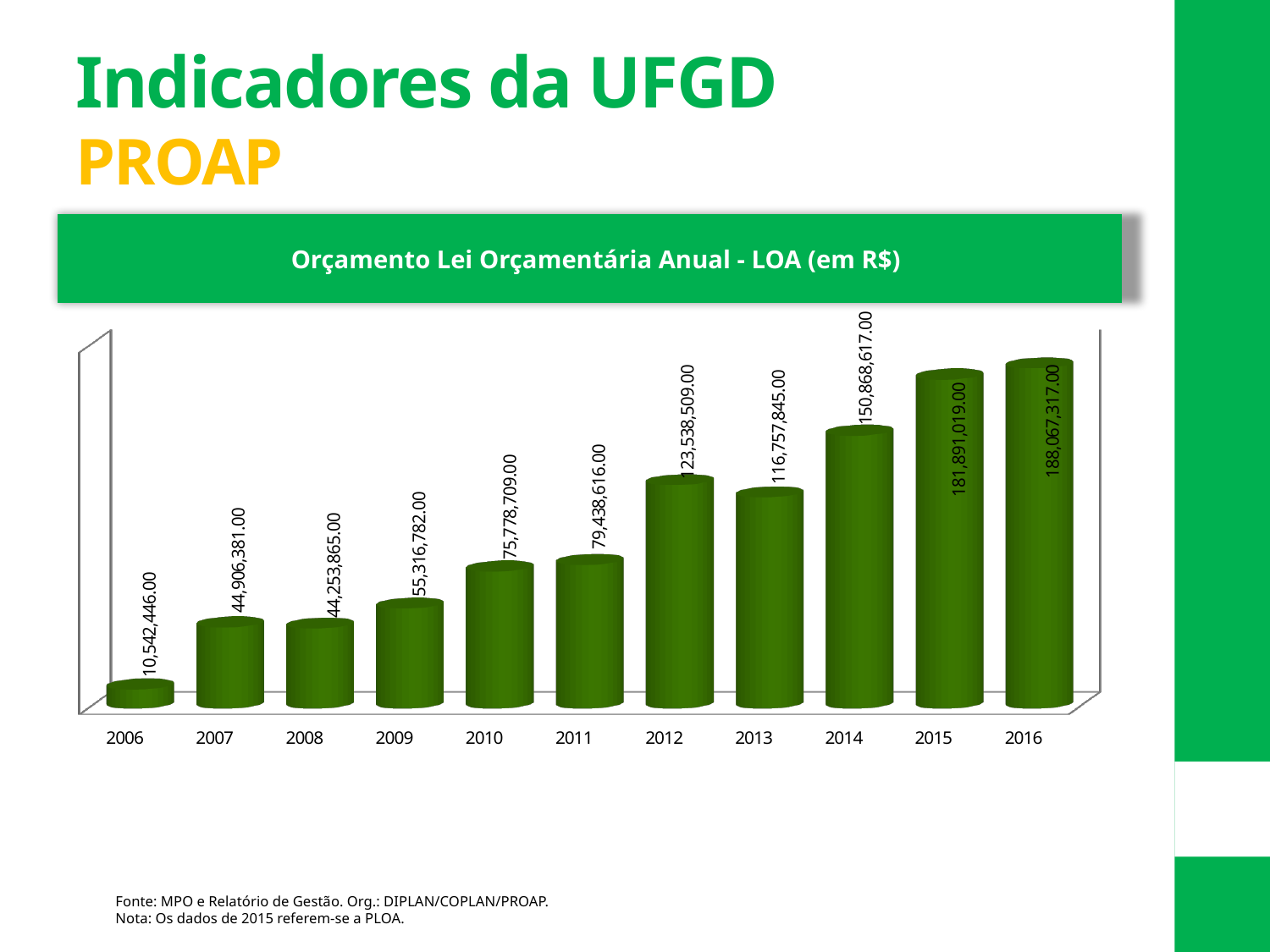
Which year has the highest value? 2016 Which is larger, the value for 2012 or the value for 2013? 2012 What type of chart is shown on the slide? Bar chart What is the title of the chart? Orçamento Lei Orçamentária Anual - LOA (em R$) What is the value for 2012? 123,538,509.00 How many years are shown on the x axis of the chart? 11 Do the values generally rise or fall from 2006 to 2016? Rise What is the value for 2006? 10,542,446.00 What is the value for 2009? 55,316,782.00 What is the value for 2015? 181,891,019.00 Which year has the lowest value? 2006 What is the difference between the values for 2016 and 2015? 6,176,298.00